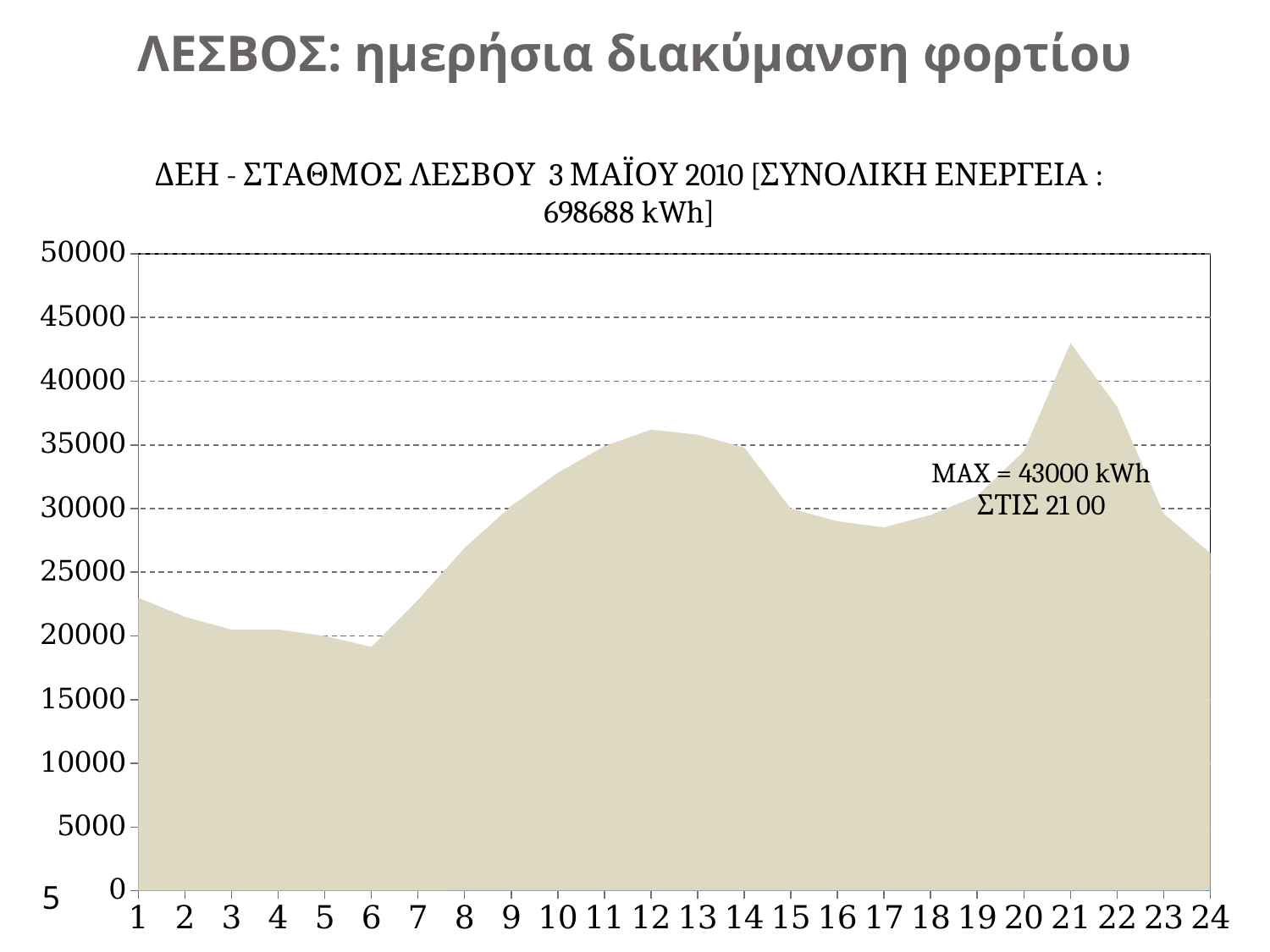
What total energy is stated in the chart title? 698688 kWh Is the value at hour 1 greater or less than 25000? less At which hour does the load reach its maximum? 21 Does the load rise or fall from hour 6 to hour 12? rise Is the value at hour 6 greater or less than 20000? less Is the value at hour 21 greater or less than 40000? greater What is the maximum load value noted on the chart? 43000 kWh What type of chart is shown on the slide? area chart How many hourly points are plotted along the x axis? 24 At which hour is the load lowest? 6 Does the load rise or fall from hour 21 to hour 24? fall